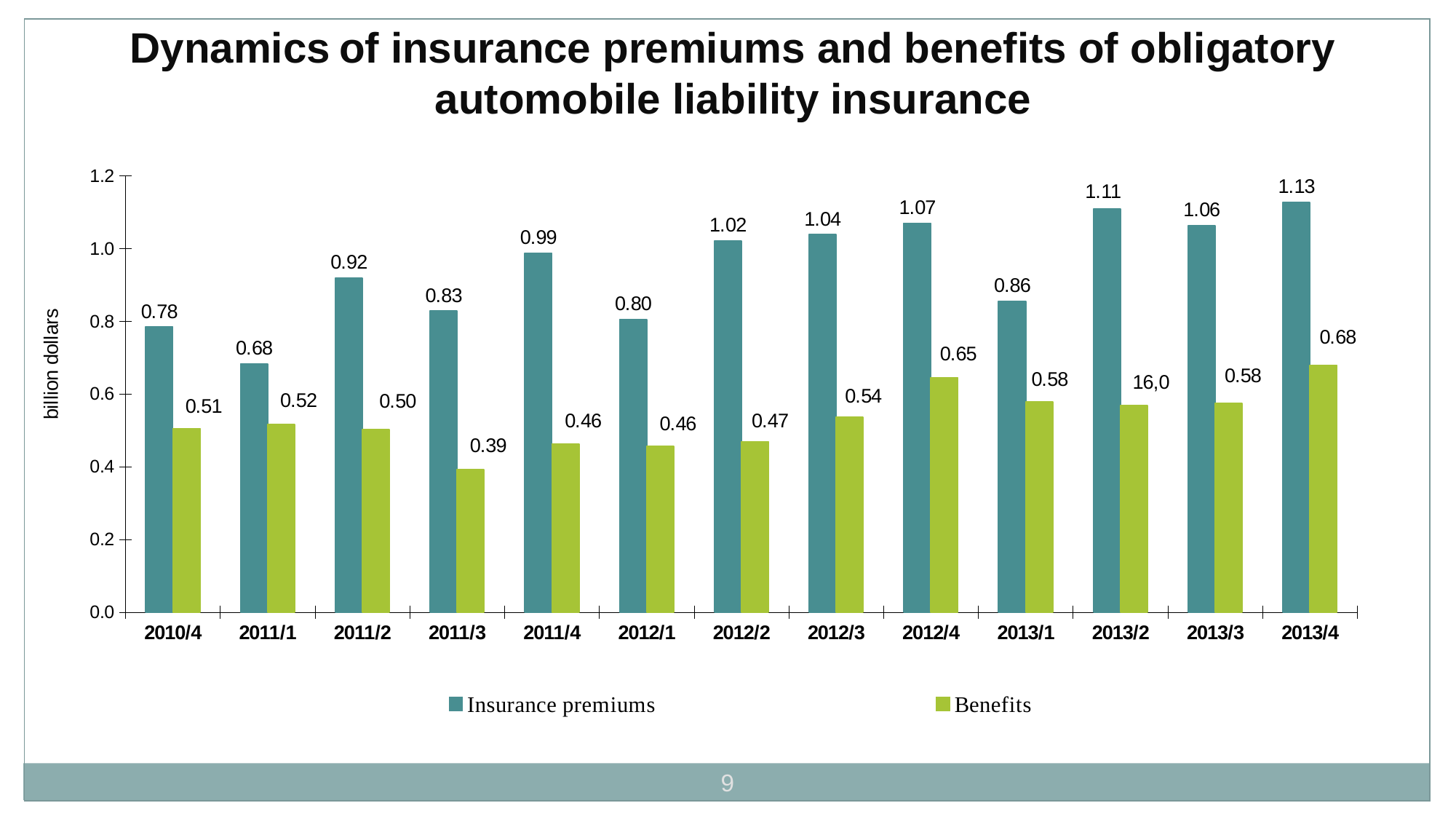
Is the Benefits value for 2013/4 greater or less than 0.6? greater What is the value of Benefits for 2011/3? 0.39 Which is larger, Insurance premiums in 2011/2 or Insurance premiums in 2013/1? Insurance premiums in 2011/2 What is the difference between Insurance premiums and Benefits in 2012/4? 0.42 How many periods are shown on the x axis? 13 What is the value of Insurance premiums for 2013/4? 1.13 What kind of chart is shown on the slide? bar chart What is the value of Insurance premiums for 2011/1? 0.68 What unit is shown on the y axis label? billion dollars Which period has the lowest Benefits value? 2011/3 How many series does the legend list? 2 Which period has the highest Insurance premiums value? 2013/4